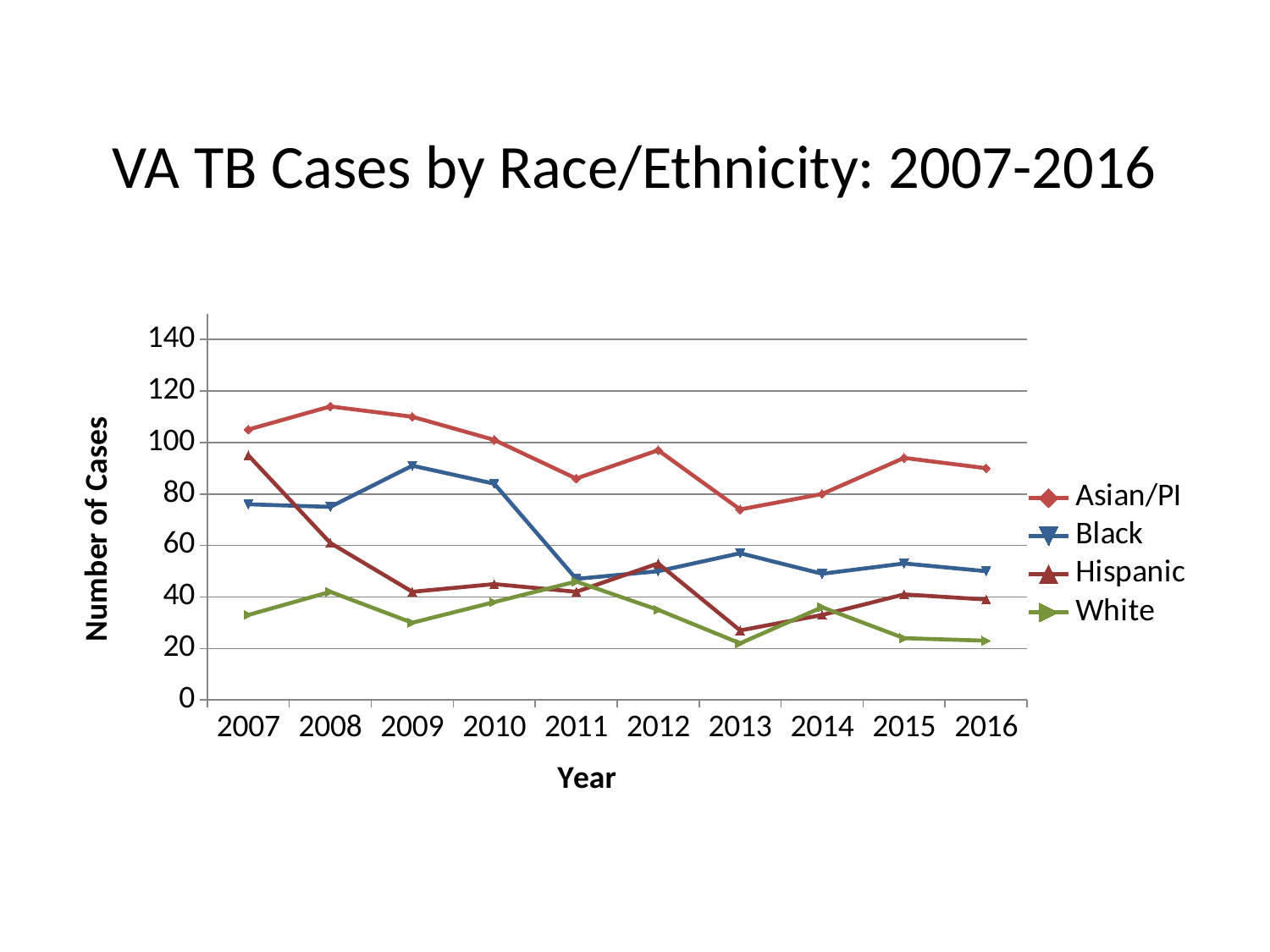
Which race/ethnicity group has the lowest number of cases in 2016? White Is the value for Hispanic in 2007 greater or less than 80? greater In which year does the Asian/PI series reach its highest value? 2008 Which race/ethnicity group has the highest number of cases in 2007? Asian/PI How many years are plotted along the x axis? 10 Is the value for Black in 2011 greater or less than 60? less What kind of chart is shown on the slide? line chart How many series does the legend list? 4 What is the title of the chart? VA TB Cases by Race/Ethnicity: 2007-2016 Which is larger in 2009, the value for Black or the value for Hispanic? Black Is the value for Asian/PI in 2008 greater or less than 100? greater In which year does the Asian/PI series reach its lowest value? 2013